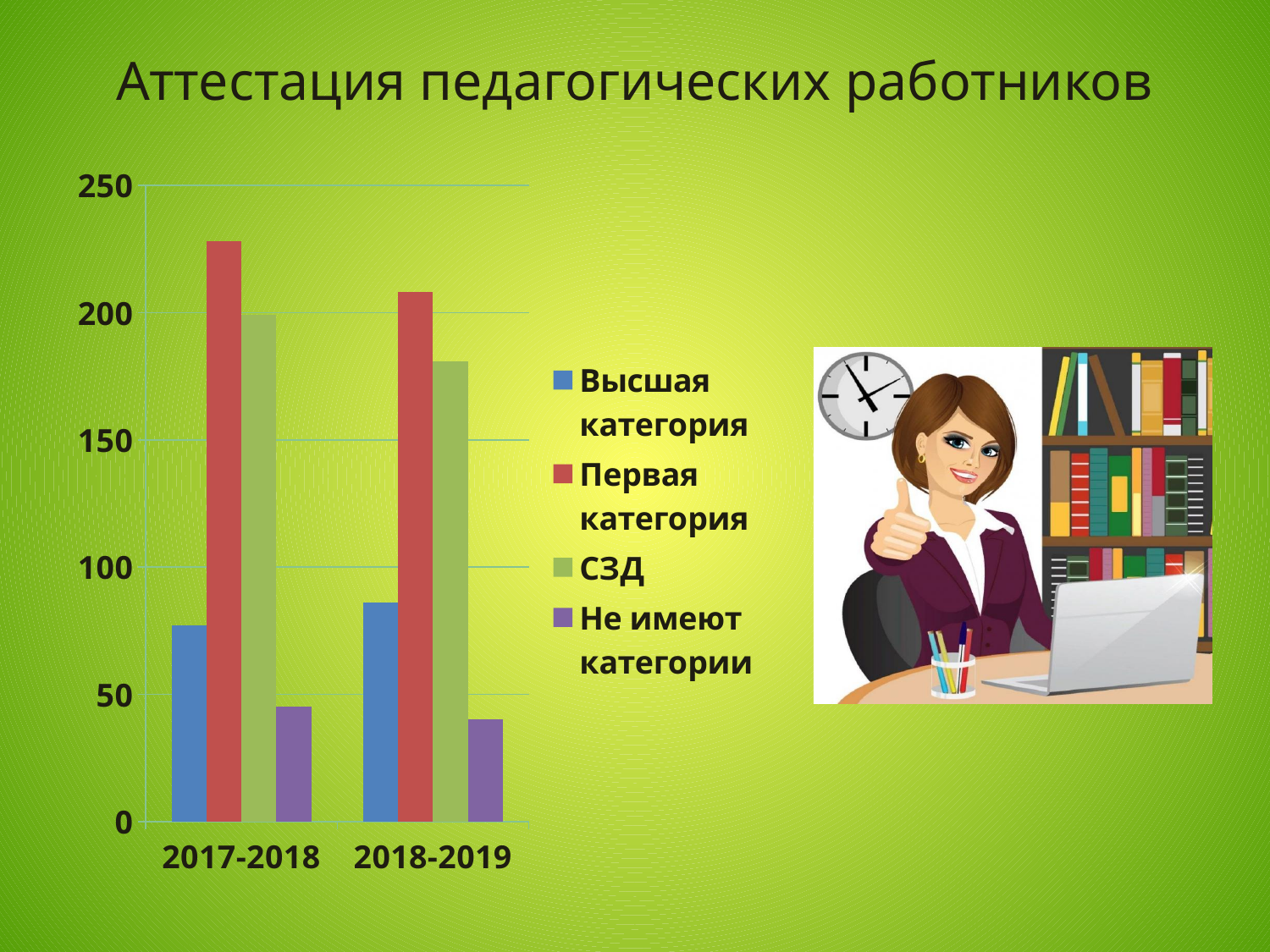
Is the value for Высшая категория in 2017-2018 greater or less than 100? less How many series does the legend list? 4 What colour represents СЗД in the legend? green How many year categories are shown on the x axis? 2 Is the value for Не имеют категории in 2018-2019 greater or less than 50? less What kind of chart is shown on the slide? bar chart Does the value for Высшая категория rise or fall from 2017-2018 to 2018-2019? rise Which series has the highest value in 2017-2018? Первая категория Is the value for Первая категория in 2017-2018 greater or less than 200? greater Which is larger: Первая категория in 2017-2018 or Первая категория in 2018-2019? 2017-2018 Which series has the lowest value in 2018-2019? Не имеют категории